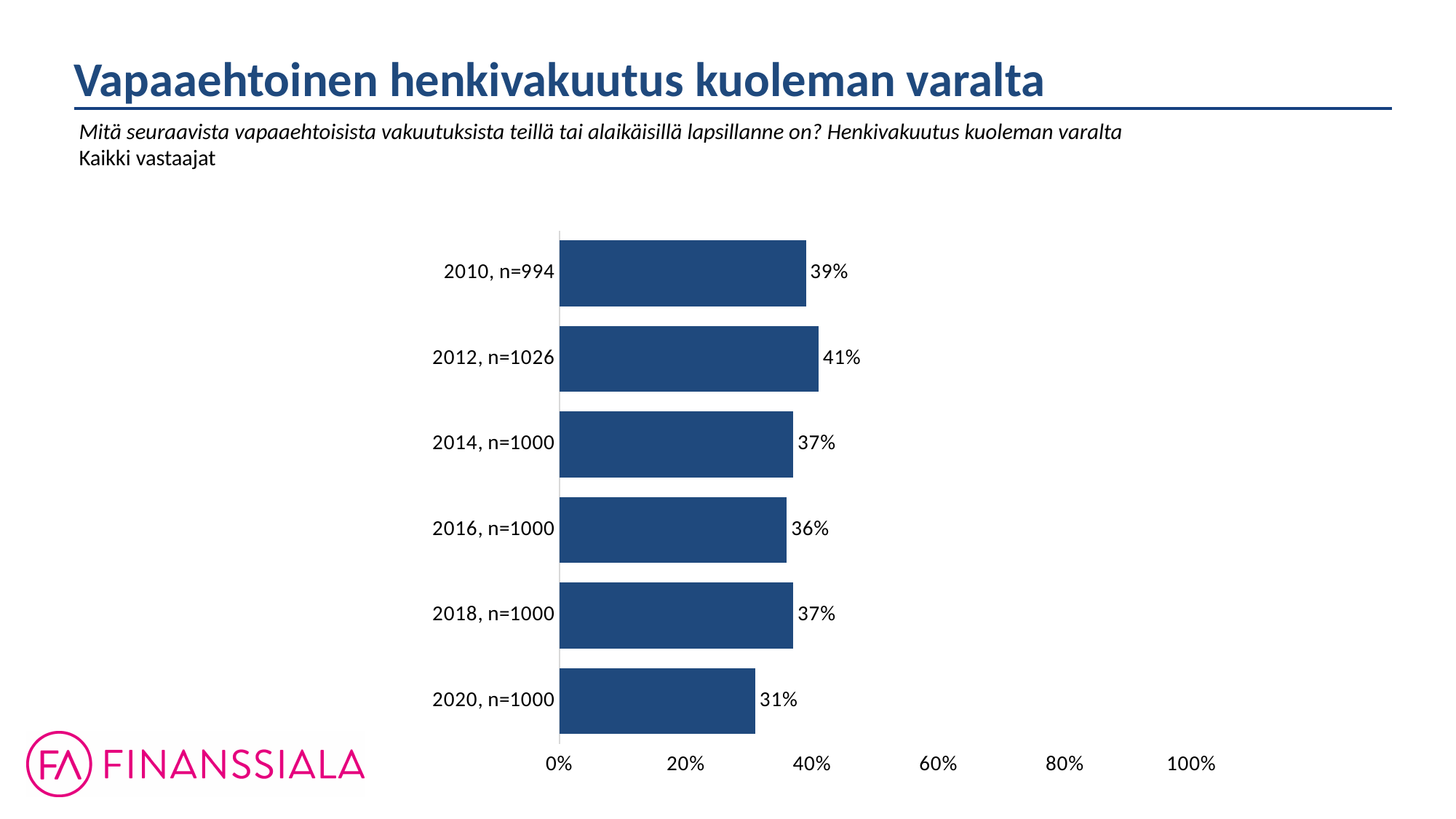
How many categories are shown in the chart? 6 What kind of chart is shown on the slide? bar chart What is the difference between the values for 2012, n=1026 and 2020, n=1000? 10% What is the value for 2020, n=1000? 31% What is the value for 2010, n=994? 39% Which category has the highest value? 2012, n=1026 What is the value for 2016, n=1000? 36% Do the values rise or fall from 2018, n=1000 to 2020, n=1000? fall Which category has the lowest value? 2020, n=1000 What is the title of the slide? Vapaaehtoinen henkivakuutus kuoleman varalta Is the value for 2012, n=1026 greater or less than 40%? greater Which is larger, the value for 2010, n=994 or the value for 2014, n=1000? 2010, n=994